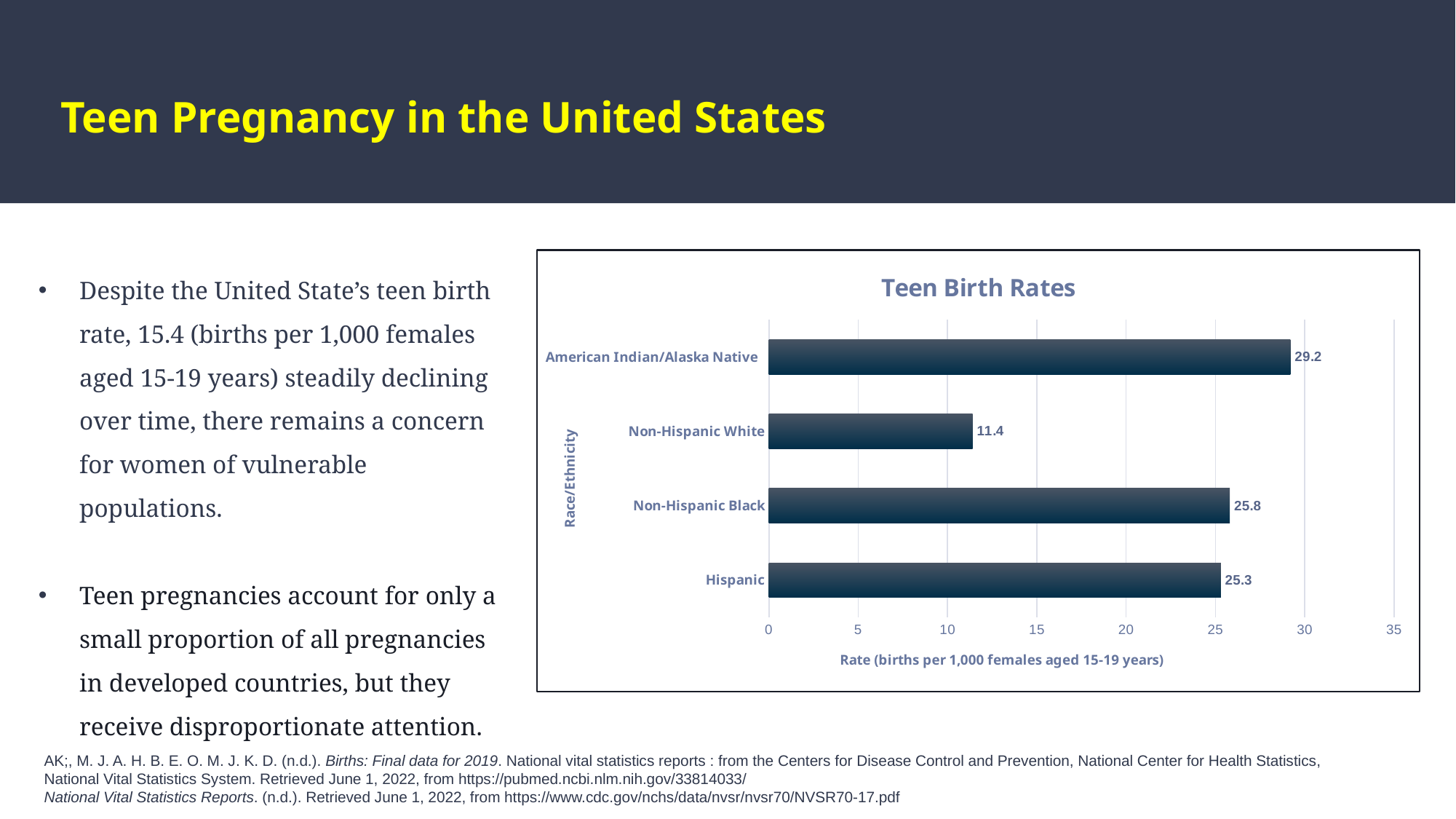
How many race/ethnicity categories are shown in the chart? 4 What kind of chart is shown on the slide? Bar chart Which race/ethnicity has the lowest teen birth rate? Non-Hispanic White What is the teen birth rate for Non-Hispanic Black? 25.8 Which has a higher teen birth rate, Non-Hispanic Black or Non-Hispanic White? Non-Hispanic Black What is the difference between the teen birth rates for Non-Hispanic Black and Hispanic? 0.5 Which race/ethnicity has the highest teen birth rate? American Indian/Alaska Native What is the teen birth rate for Hispanic? 25.3 What is the difference between the teen birth rates for American Indian/Alaska Native and Non-Hispanic White? 17.8 What is the teen birth rate for Non-Hispanic White? 11.4 What is the teen birth rate for American Indian/Alaska Native? 29.2 What is the title of the chart? Teen Birth Rates